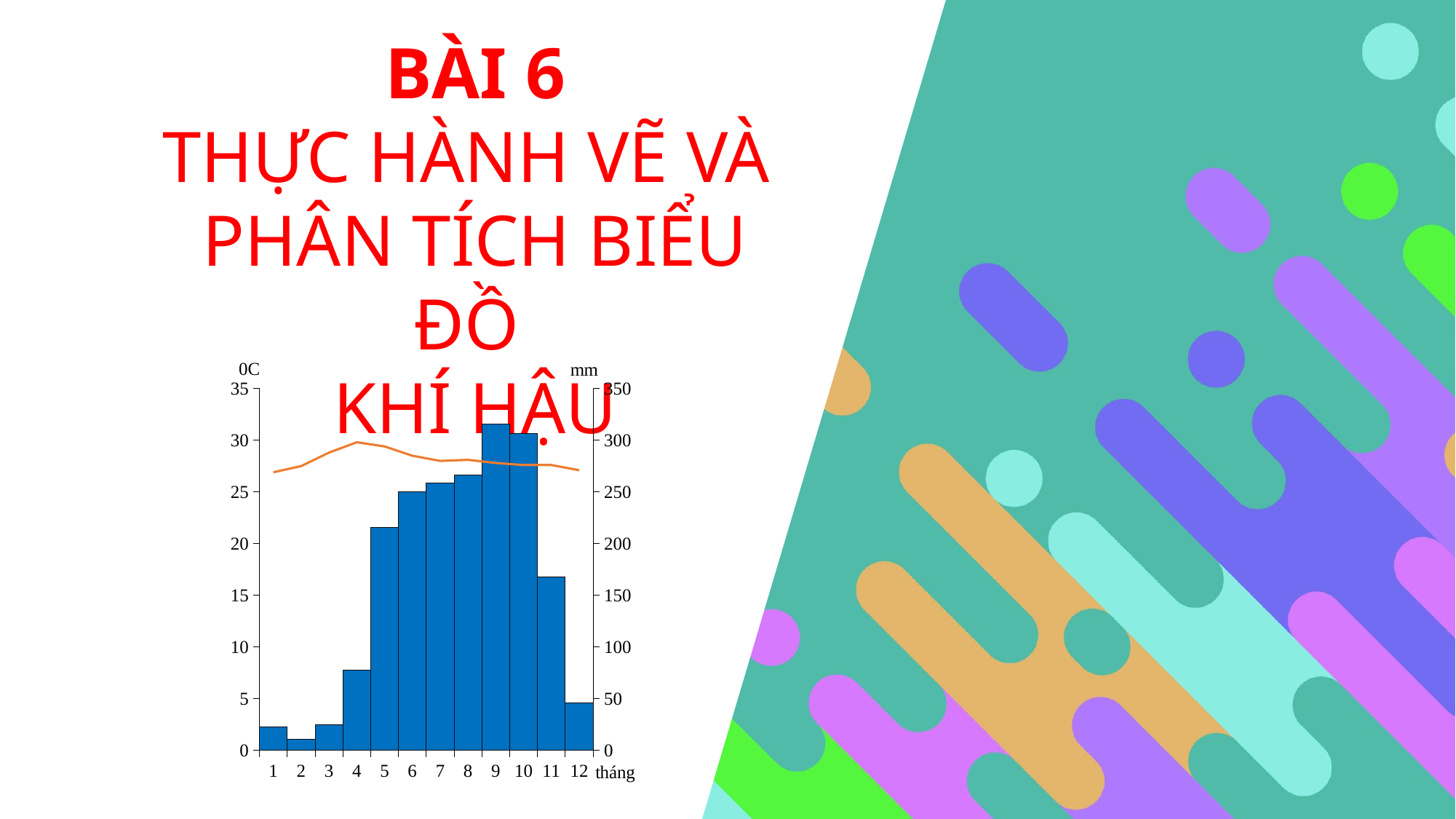
What unit is shown on the right-hand vertical axis? mm How many months (categories) are plotted along the x axis? 12 Which month has the shortest precipitation bar? 2 Which has the larger precipitation bar, month 9 or month 11? Month 9 Which month has the tallest precipitation bar? 9 Is the precipitation bar for month 5 greater or less than 200 mm? greater What label is written at the end of the x axis? tháng Is the precipitation bar for month 4 greater or less than 100 mm? less Is the precipitation bar for month 9 greater or less than 300 mm? greater Do the precipitation bars generally rise or fall from month 1 to month 9? Rise What kind of chart is shown on the slide? A combined bar and line chart